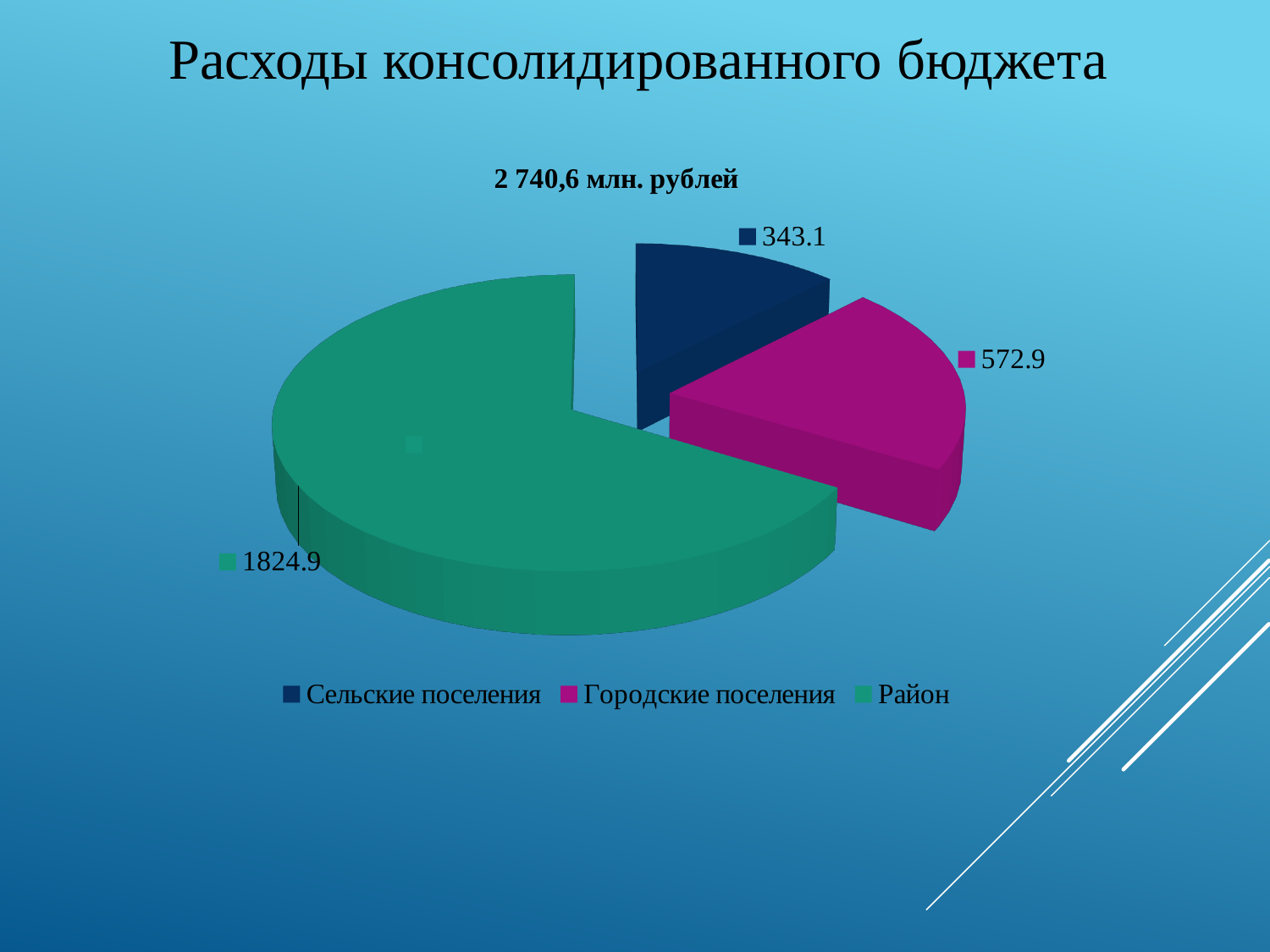
What kind of chart is shown on the slide? pie chart What colour is the slice for Городские поселения? magenta Which category has the smallest slice of the pie? Сельские поселения What is the value for Сельские поселения? 343.1 What is the title shown above the pie chart? 2 740,6 млн. рублей What is the value for Городские поселения? 572.9 How many slices does the pie chart have? 3 What is the value for Район? 1824.9 Which is larger, the value for Городские поселения or the value for Сельские поселения? Городские поселения Which category has the largest slice of the pie? Район What is the difference between the values for Район and Городские поселения? 1252.0 What is the difference between the values for Городские поселения and Сельские поселения? 229.8